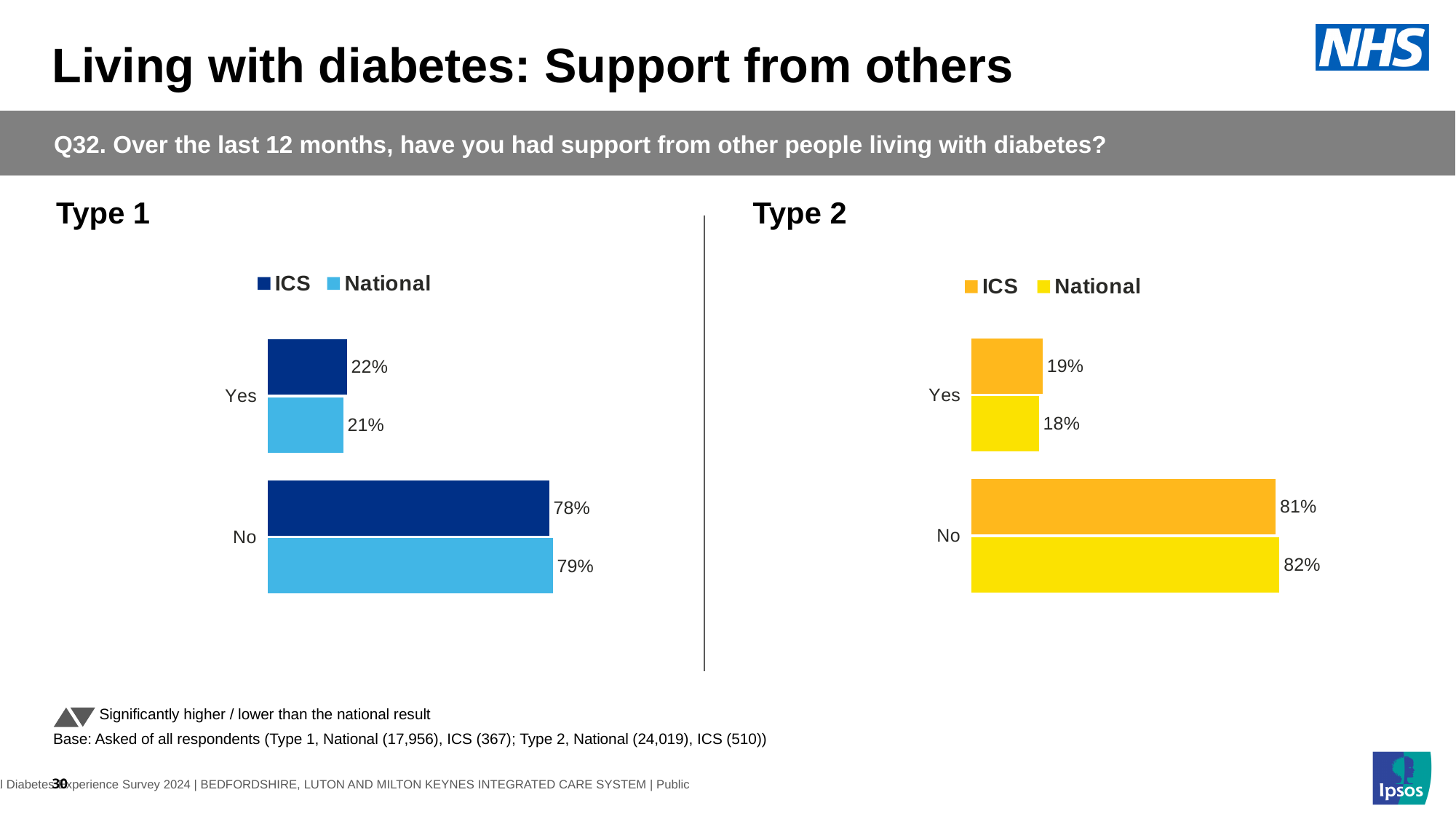
What kind of chart is the Type 2 chart? bar chart In the Type 2 chart, what is the National value for Yes? 18% In the Type 2 chart, what is the ICS value for No? 81% How many series does the legend of the Type 2 chart list? 2 In the Type 2 chart, which category has the highest ICS value? No How many categories are shown in the Type 1 chart? 2 In the Type 1 chart, which category has the lowest National value? Yes In the Type 1 chart, what is the ICS value for Yes? 22% In the Type 2 chart, what is the difference between the ICS and National values for Yes? 1% In the Type 1 chart, is the ICS value for No larger or smaller than the ICS value for Yes? larger In the Type 1 chart, what is the National value for No? 79% In the Type 1 chart, what is the difference between the ICS and National values for No? 1%